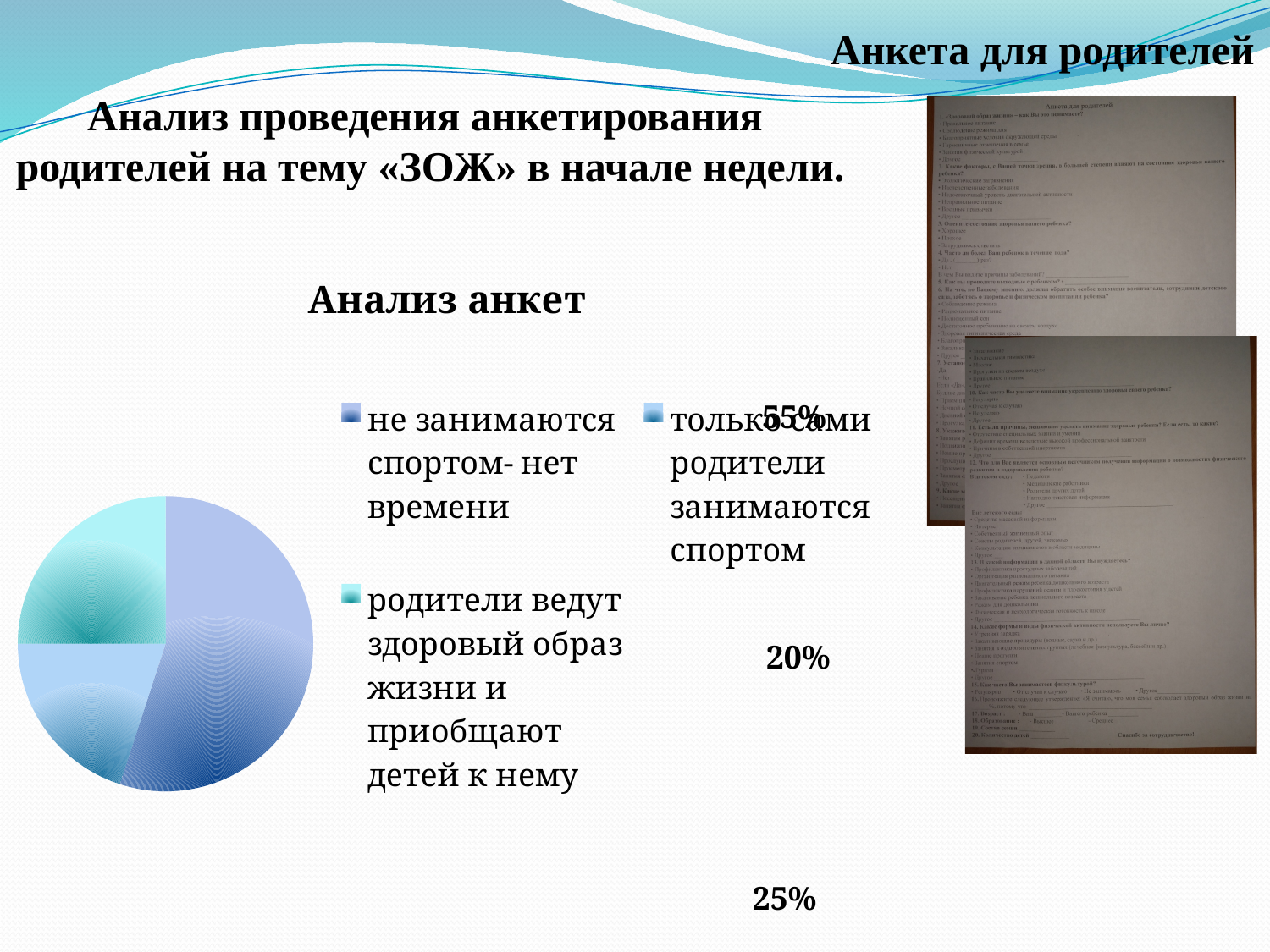
What is the title of the chart on the slide? Анализ анкет What kind of chart is shown on the slide? pie chart Which category has the largest slice in the pie chart? не занимаются спортом- нет времени Which slice is larger: "не занимаются спортом- нет времени" or "родители ведут здоровый образ жизни и приобщают детей к нему"? не занимаются спортом- нет времени What colour is the slice for "не занимаются спортом- нет времени" in the pie chart? blue What is the largest percentage value printed on the chart? 55% How many slices does the pie chart have? 3 Which slice is larger: "не занимаются спортом- нет времени" or "только сами родители занимаются спортом"? не занимаются спортом- нет времени What share of the pie does the category "не занимаются спортом- нет времени" take? 55% How many entries does the legend of the pie chart list? 3